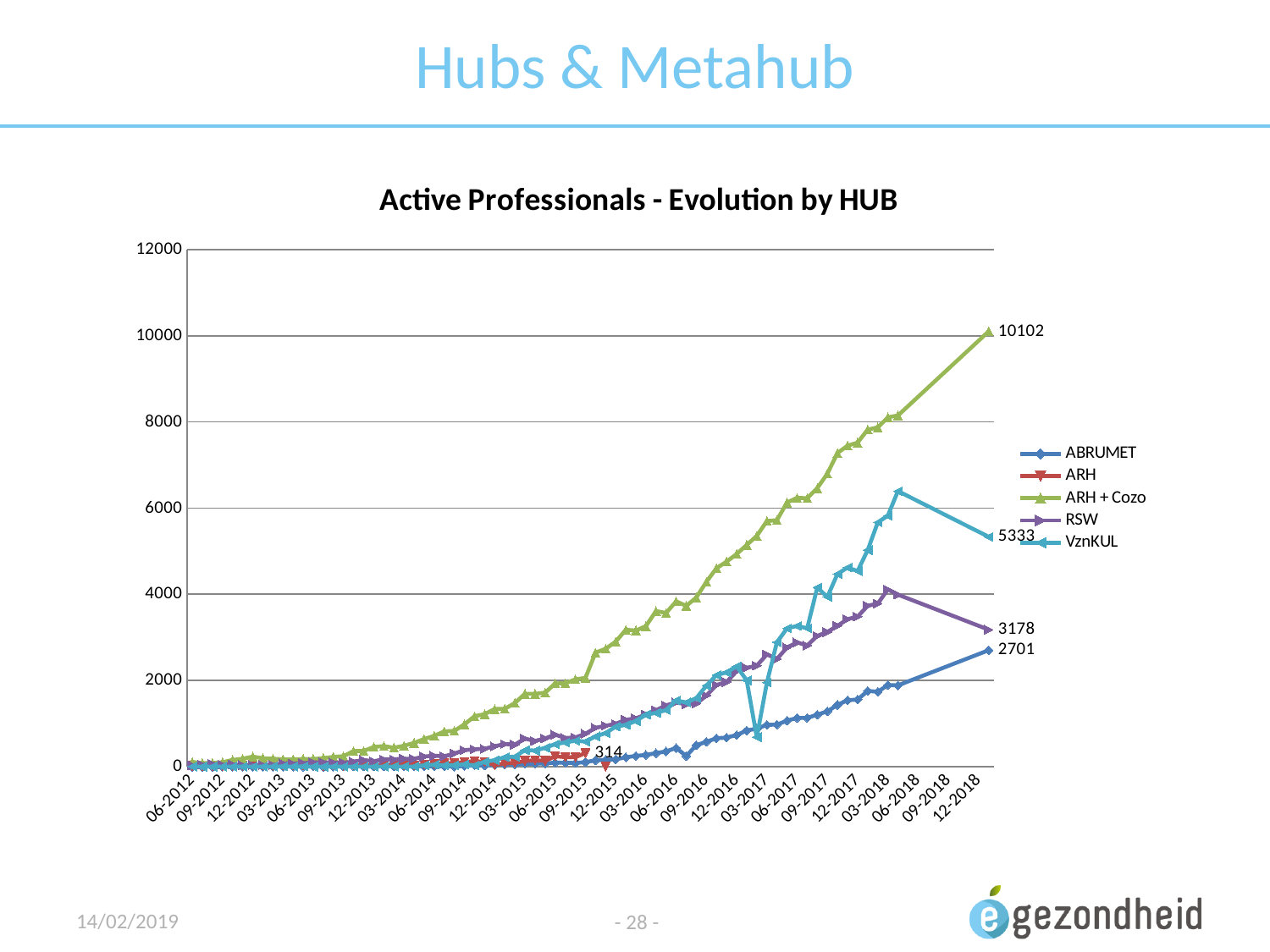
How many series does the legend list? 5 Is the value for ABRUMET at 12-2017 greater or less than 2000? less What is the difference between the ARH + Cozo and VznKUL values at 12-2018? 4769 What is the value for VznKUL at 12-2018? 5333 What kind of chart is shown on the slide? line chart What is the last labelled value for the ARH series? 314 What is the value for RSW at 12-2018? 3178 What is the value for ABRUMET at 12-2018? 2701 Which series has the lowest value at 12-2018? ABRUMET Which is larger at 12-2018, VznKUL or RSW? VznKUL What is the value for ARH + Cozo at 12-2018? 10102 Which series has the highest value at 12-2018? ARH + Cozo